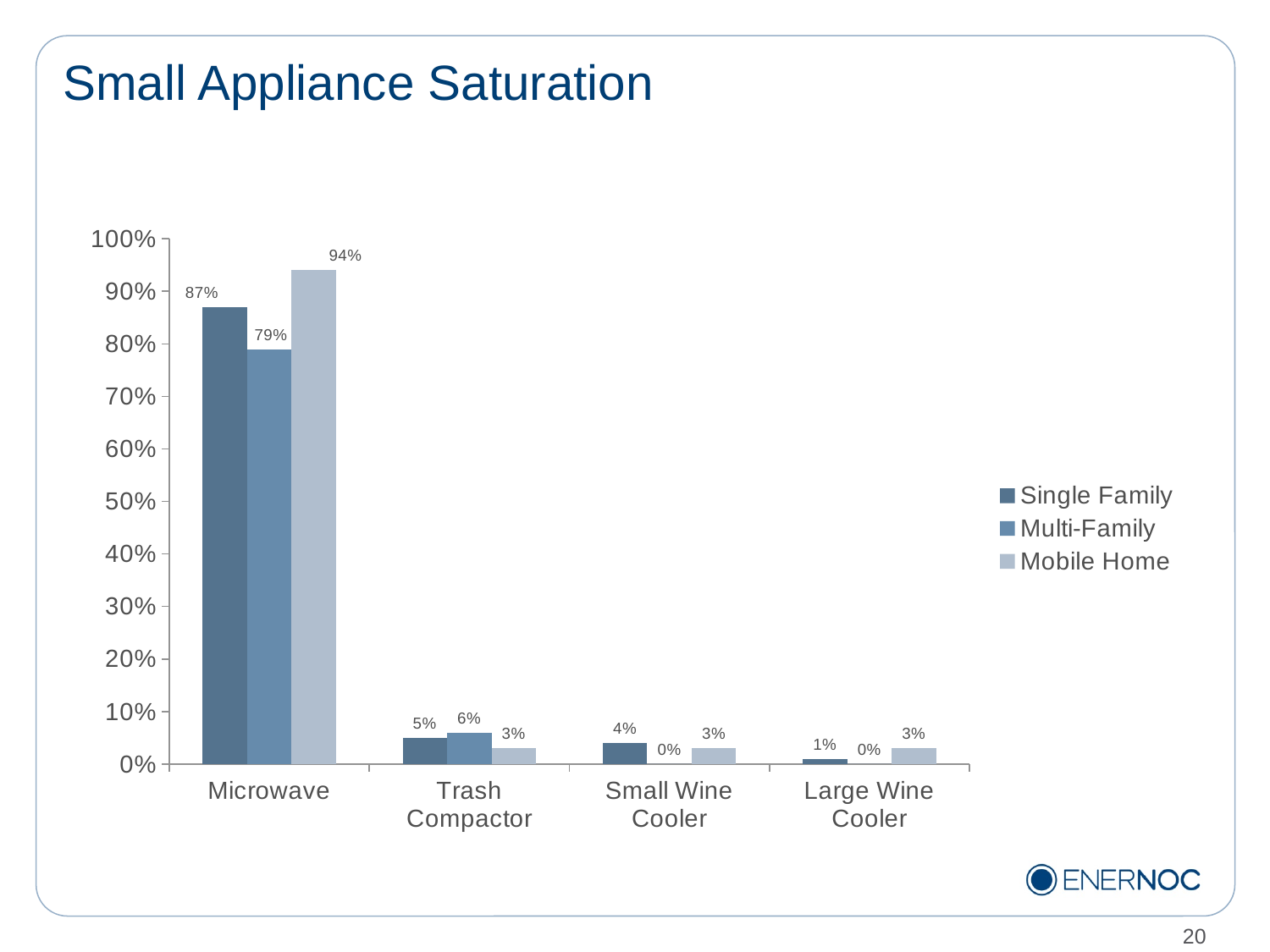
What is the Mobile Home value for Microwave? 94% What is the Multi-Family value for Trash Compactor? 6% For Small Wine Cooler, which is larger: the Single Family value or the Mobile Home value? Single Family How many appliance categories are shown on the x axis? 4 What is the title of the slide? Small Appliance Saturation What kind of chart is shown on the slide? Bar chart Is the Single Family value for Microwave greater or less than 80%? greater What is the difference between the Mobile Home and Multi-Family values for Microwave? 15% What is the Single Family value for Large Wine Cooler? 1% Which category has the highest Single Family value? Microwave How many series does the legend list? 3 Which category has the lowest Mobile Home value? Trash Compactor, Small Wine Cooler and Large Wine Cooler (all 3%)